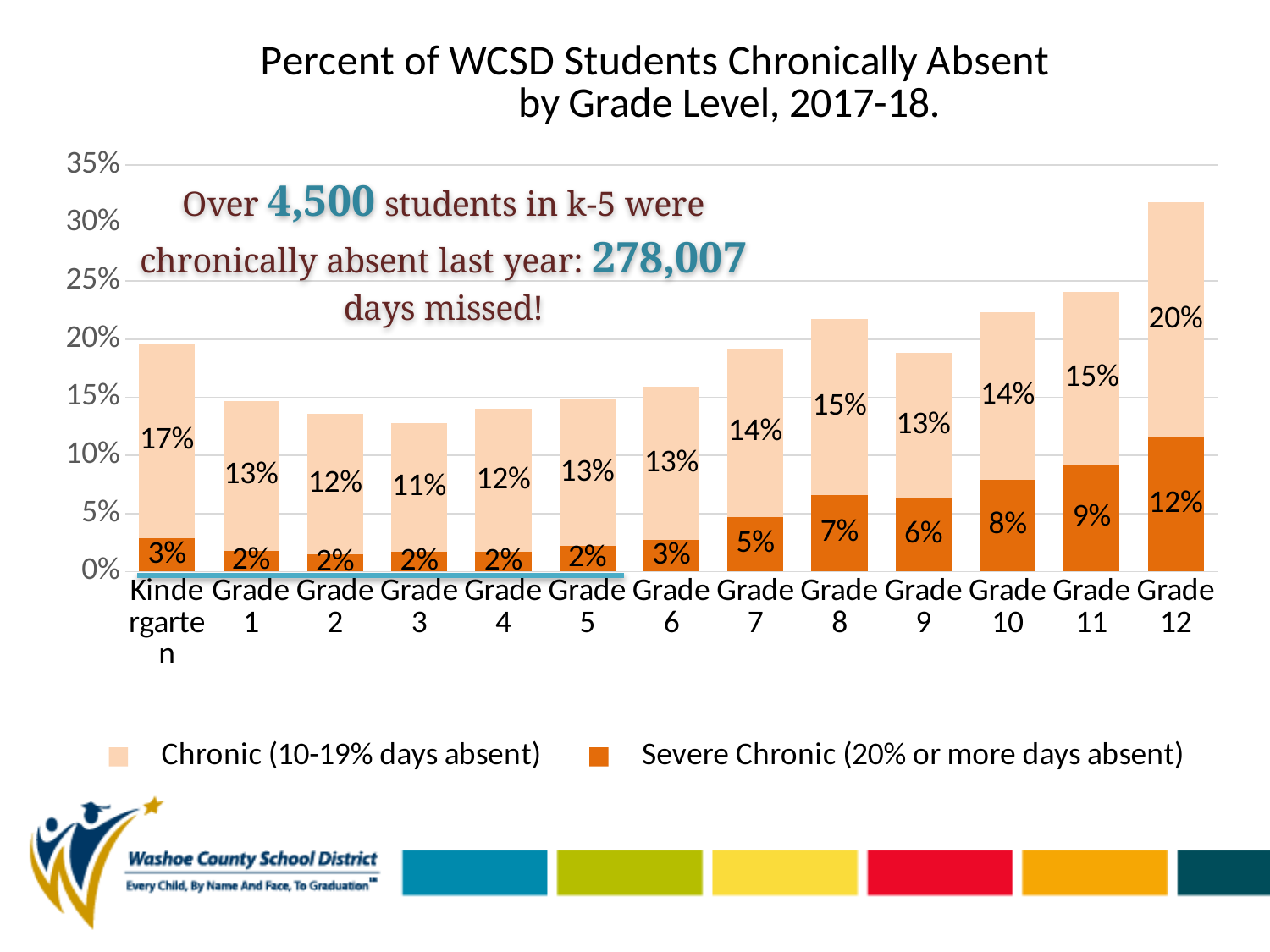
Which is larger, the Severe Chronic value for Grade 8 or for Grade 9? Grade 8 How many grade levels are shown on the x axis? 13 What is the difference between the Chronic (10-19% days absent) values for Grade 12 and Grade 3? 9% What is the Chronic (10-19% days absent) value for Kindergarten? 17% What is the Chronic (10-19% days absent) value for Grade 8? 15% What kind of chart is shown on the slide? Stacked bar chart Which grade level has the lowest Chronic (10-19% days absent) value? Grade 3 Which grade level has the highest Severe Chronic (20% or more days absent) value? Grade 12 Is the total stacked value for Grade 12 greater or less than 30%? greater What is the Severe Chronic (20% or more days absent) value for Grade 12? 12% What is the total stacked value (Chronic plus Severe Chronic) for Grade 12? 32% How many series does the legend list? 2